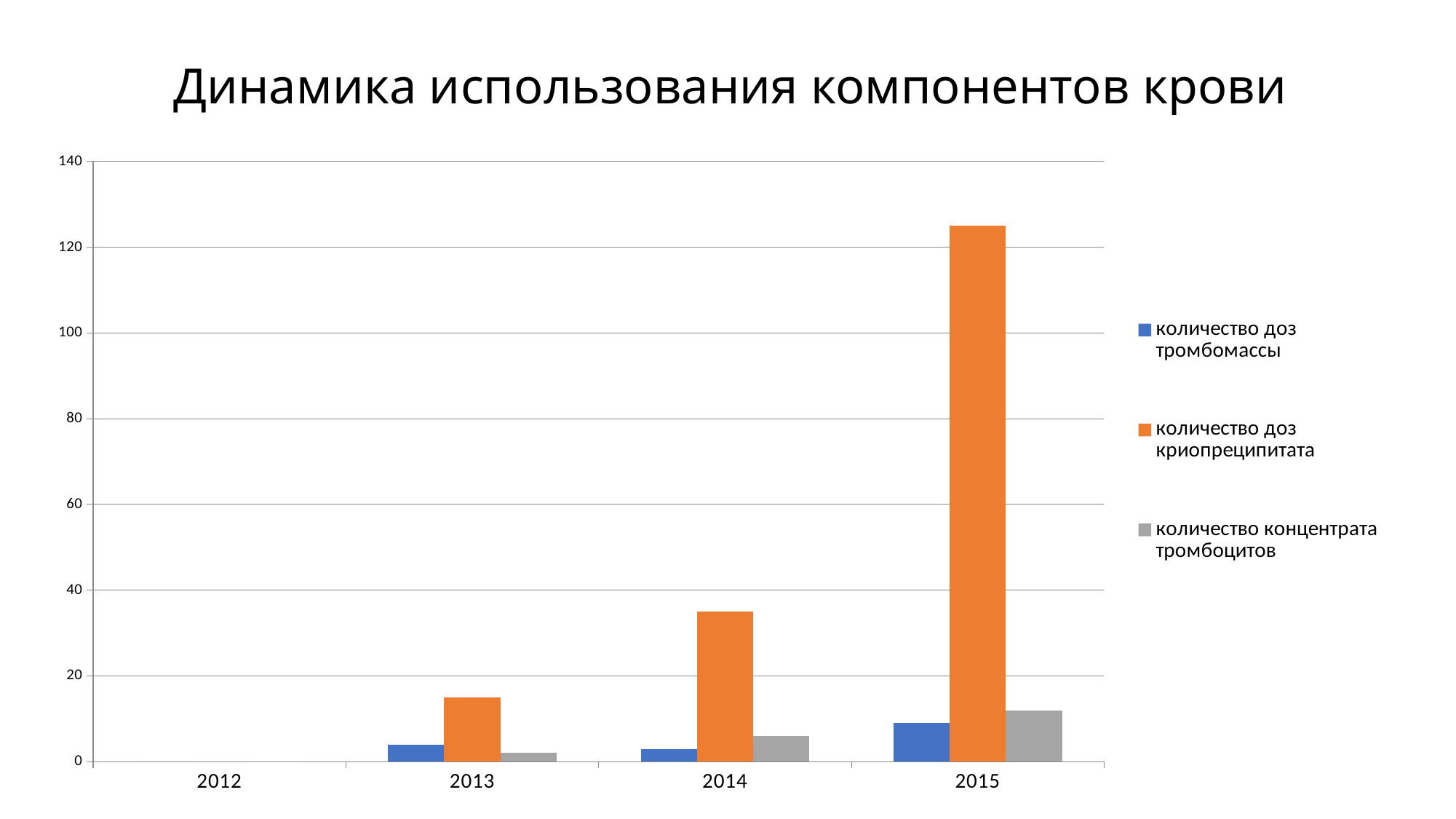
Do the values for 'количество доз криопреципитата' rise or fall from 2013 to 2015? rise Which is larger: the value for 'количество доз криопреципитата' in 2014 or in 2013? 2014 Is the value for 'количество доз криопреципитата' in 2014 greater or less than 40? less How many series does the legend list? 3 What kind of chart is shown on the slide? bar chart Is the value for 'количество доз криопреципитата' in 2013 greater or less than 20? less Which colour represents 'количество доз криопреципитата' in the legend? orange Is the value for 'количество доз криопреципитата' in 2015 greater or less than 120? greater What is the title of the chart? Динамика использования компонентов крови How many years are shown on the x axis? 4 In which year is the value for 'количество доз криопреципитата' highest? 2015